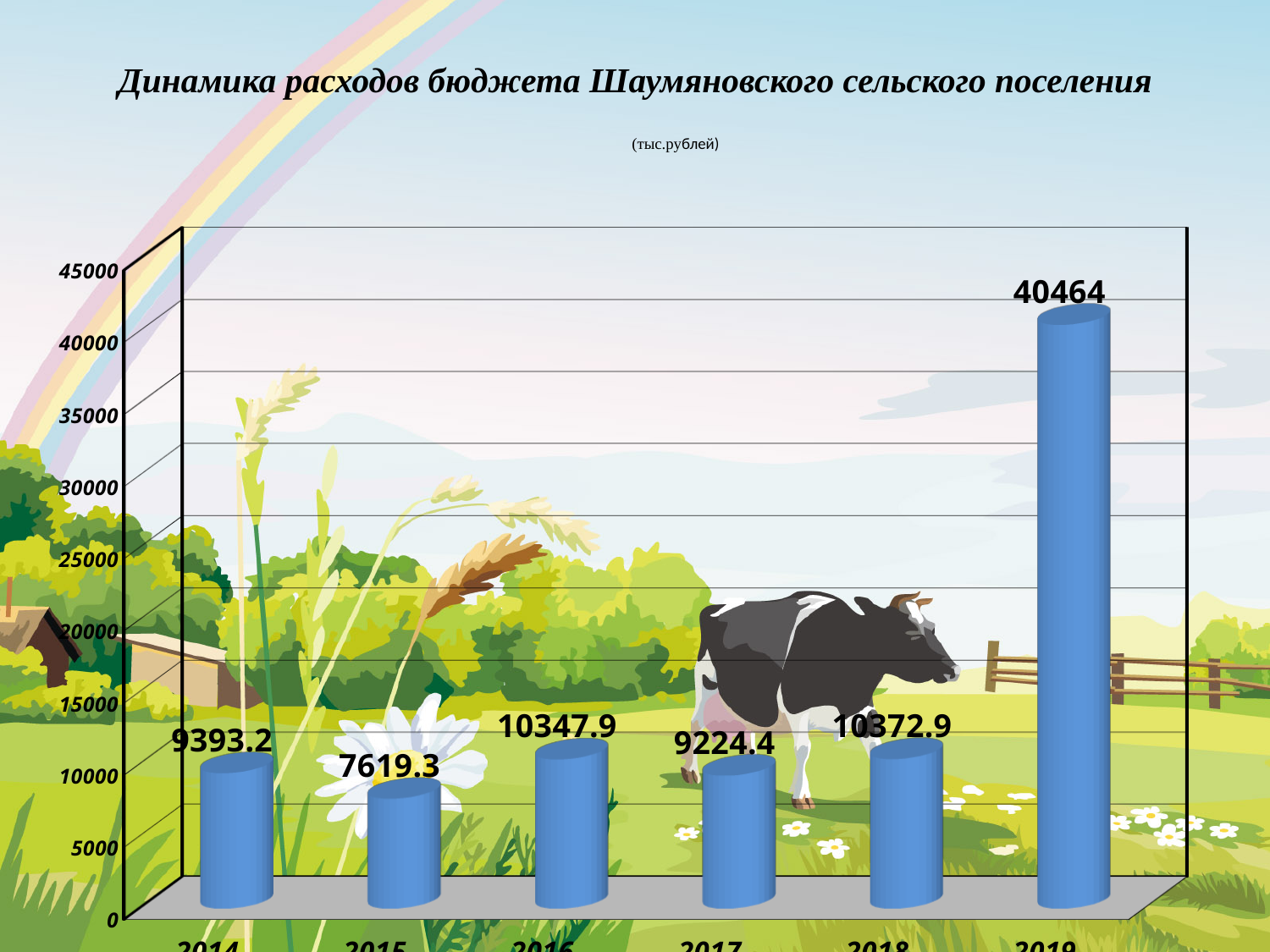
What is the difference between the values for 2014 and 2015? 1773.9 Which is larger, the value for 2014 or the value for 2015? 2014 Which year has the lowest value? 2015 What is the difference between the values for 2019 and 2018? 30091.1 Is the value for 2016 greater or less than 15000? less What is the value for 2019? 40464 What is the value for 2015? 7619.3 What is the value for 2017? 9224.4 In what units are the values on the chart given, according to the subtitle? тыс.рублей What kind of chart is shown on the slide? bar chart Which year has the highest value? 2019 How many years are shown on the chart? 6